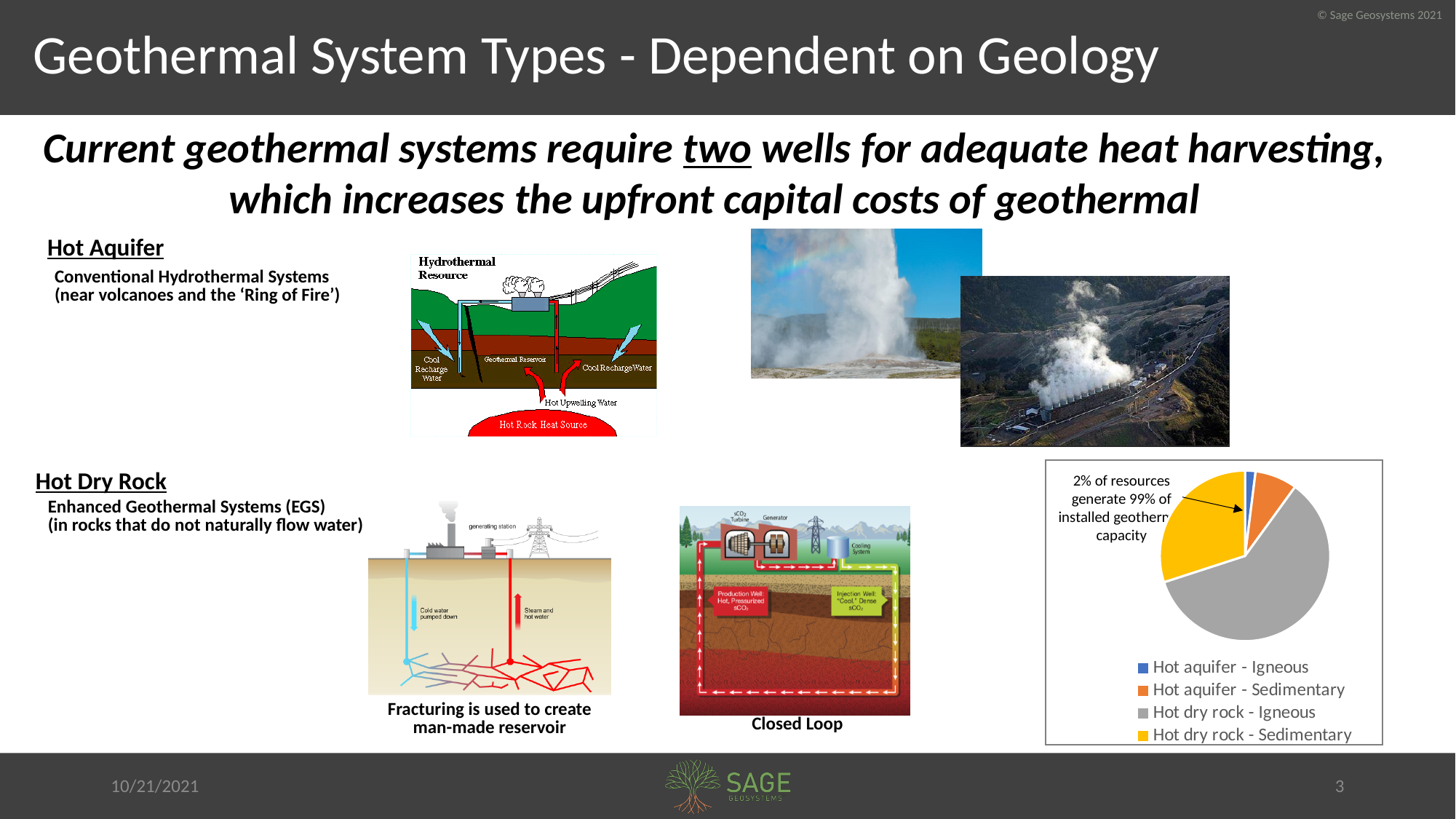
Which category has the smallest slice of the pie chart? Hot aquifer - Igneous Which slice is larger in the pie chart: Hot aquifer - Sedimentary or Hot aquifer - Igneous? Hot aquifer - Sedimentary Which category does the annotation '2% of resources generate 99% of installed geothermal capacity' point to in the pie chart? Hot aquifer - Igneous What kind of chart is shown on the slide? Pie chart What colour is the Hot dry rock - Igneous slice in the pie chart? Gray Which category has the largest slice of the pie chart? Hot dry rock - Igneous How many categories does the pie chart's legend list? 4 Which slice is larger in the pie chart: Hot dry rock - Igneous or Hot dry rock - Sedimentary? Hot dry rock - Igneous Which slice is larger in the pie chart: Hot dry rock - Sedimentary or Hot aquifer - Sedimentary? Hot dry rock - Sedimentary